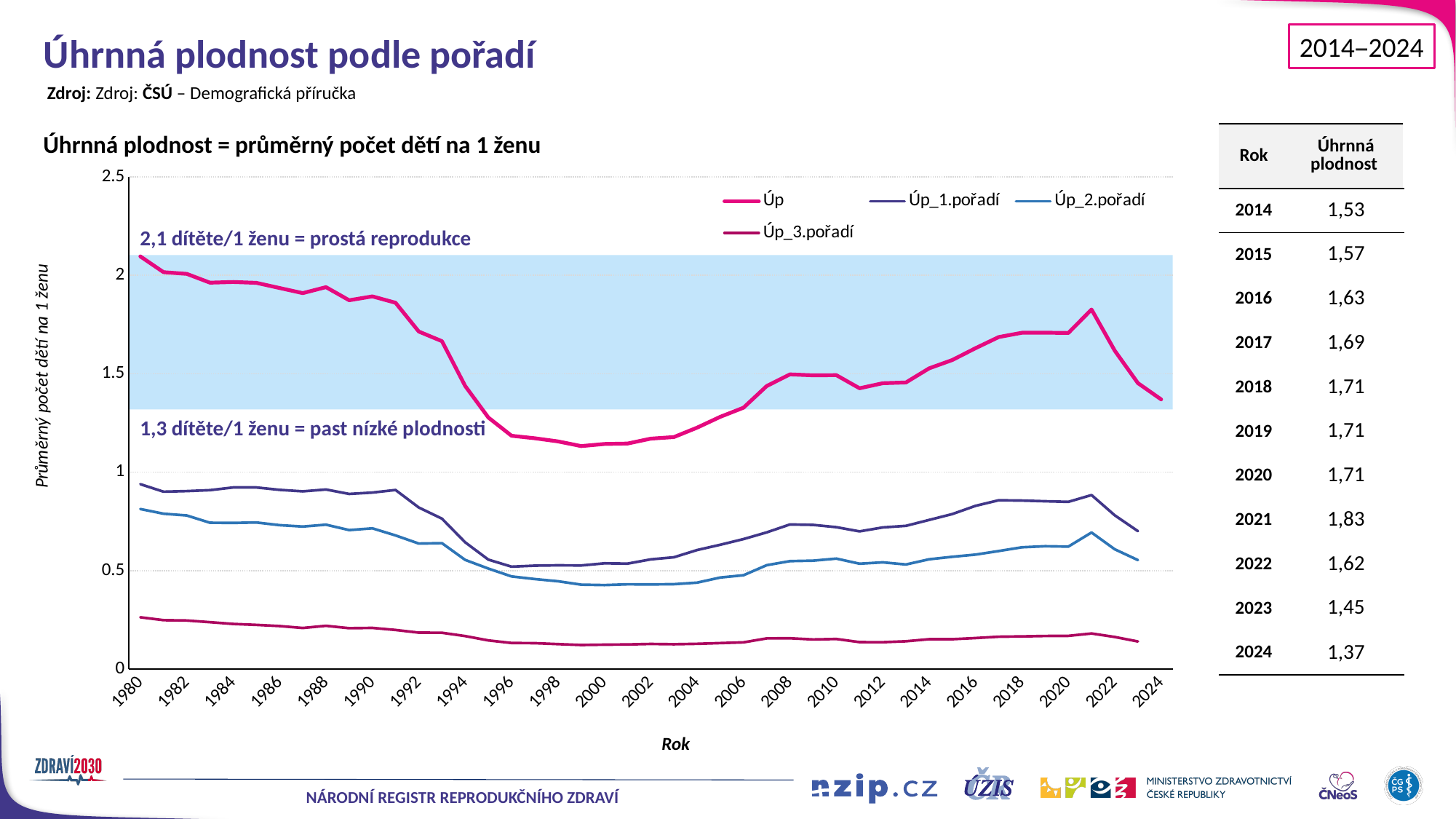
Is the value of the Úp series in 1980 greater or less than 2? greater According to the table, what was the value of Úhrnná plodnost in 2021? 1,83 Does the Úp series rise or fall between 1980 and 1999? fall According to the table, what was the value of Úhrnná plodnost in 2024? 1,37 According to the table, was Úhrnná plodnost higher in 2018 or in 2022? 2018 Among the years listed in the table (2014–2024), which year has the highest Úhrnná plodnost? 2021 Is the value of the Úp series in 2000 greater or less than 1.5? less What kind of chart is shown on the slide? line chart Among the years listed in the table (2014–2024), which year has the lowest Úhrnná plodnost? 2024 What is the label of the vertical axis of the chart? Průměrný počet dětí na 1 ženu By how much did Úhrnná plodnost fall between 2021 and 2024, according to the table? 0,46 How many series does the chart legend list? 4